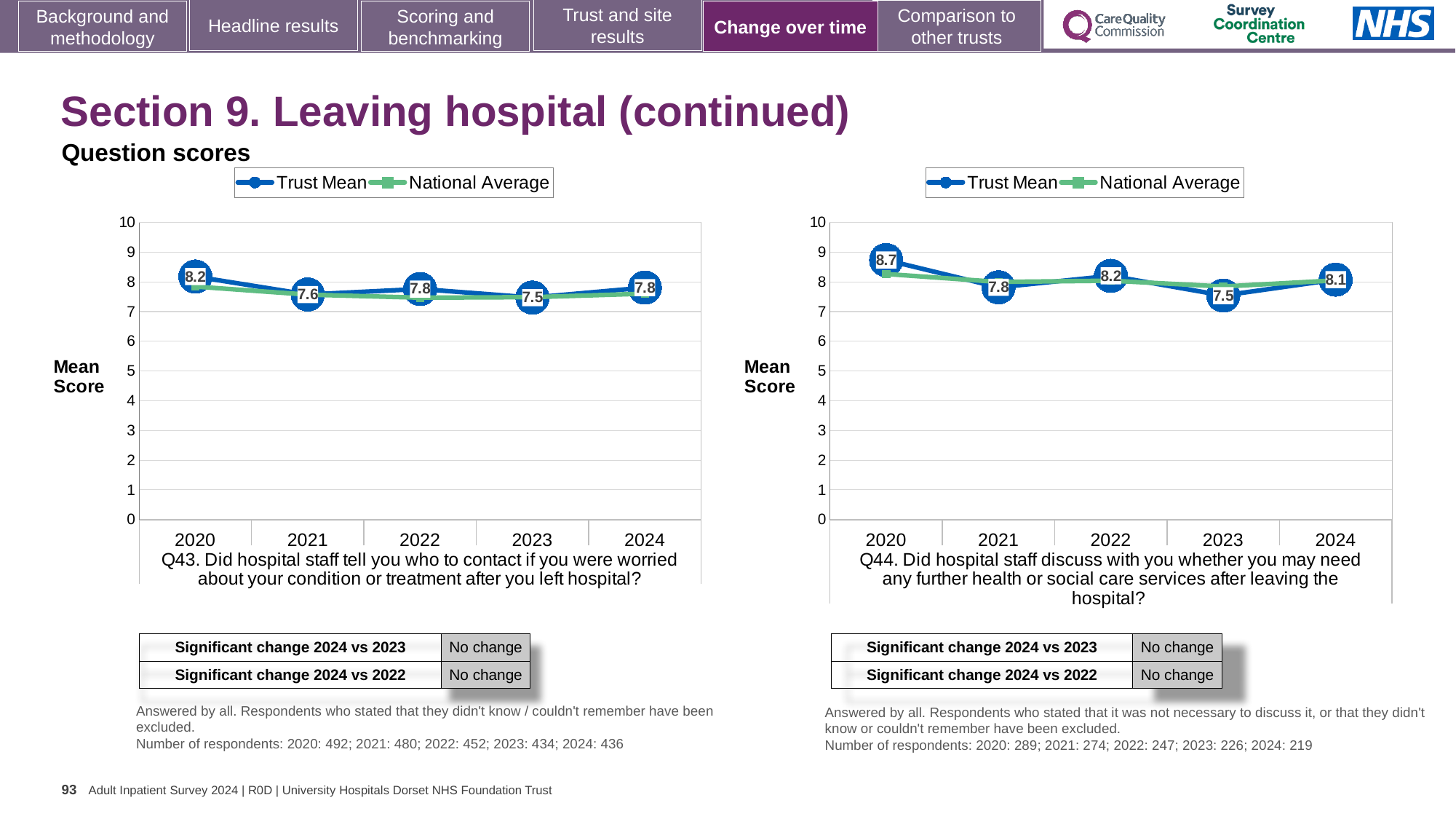
How many years are plotted on the x axis of the left chart (Q43)? 5 In the left chart (Q43), what is the Trust Mean score for 2023? 7.5 How many series does the legend of the right chart (Q44) list? 2 In the right chart (Q44), is the National Average for 2020 greater or less than 8? greater In the right chart (Q44), what is the Trust Mean score for 2020? 8.7 In the left chart (Q43), is the Trust Mean score for 2021 or 2022 larger? 2022 What kind of chart is the left chart (Q43)? Line chart In the left chart (Q43), what is the Trust Mean score for 2020? 8.2 In the right chart (Q44), which year has the lowest Trust Mean score? 2023 In the right chart (Q44), what is the Trust Mean score for 2024? 8.1 In the right chart (Q44), what is the difference between the Trust Mean scores for 2020 and 2023? 1.2 In the left chart (Q43), which year has the highest Trust Mean score? 2020